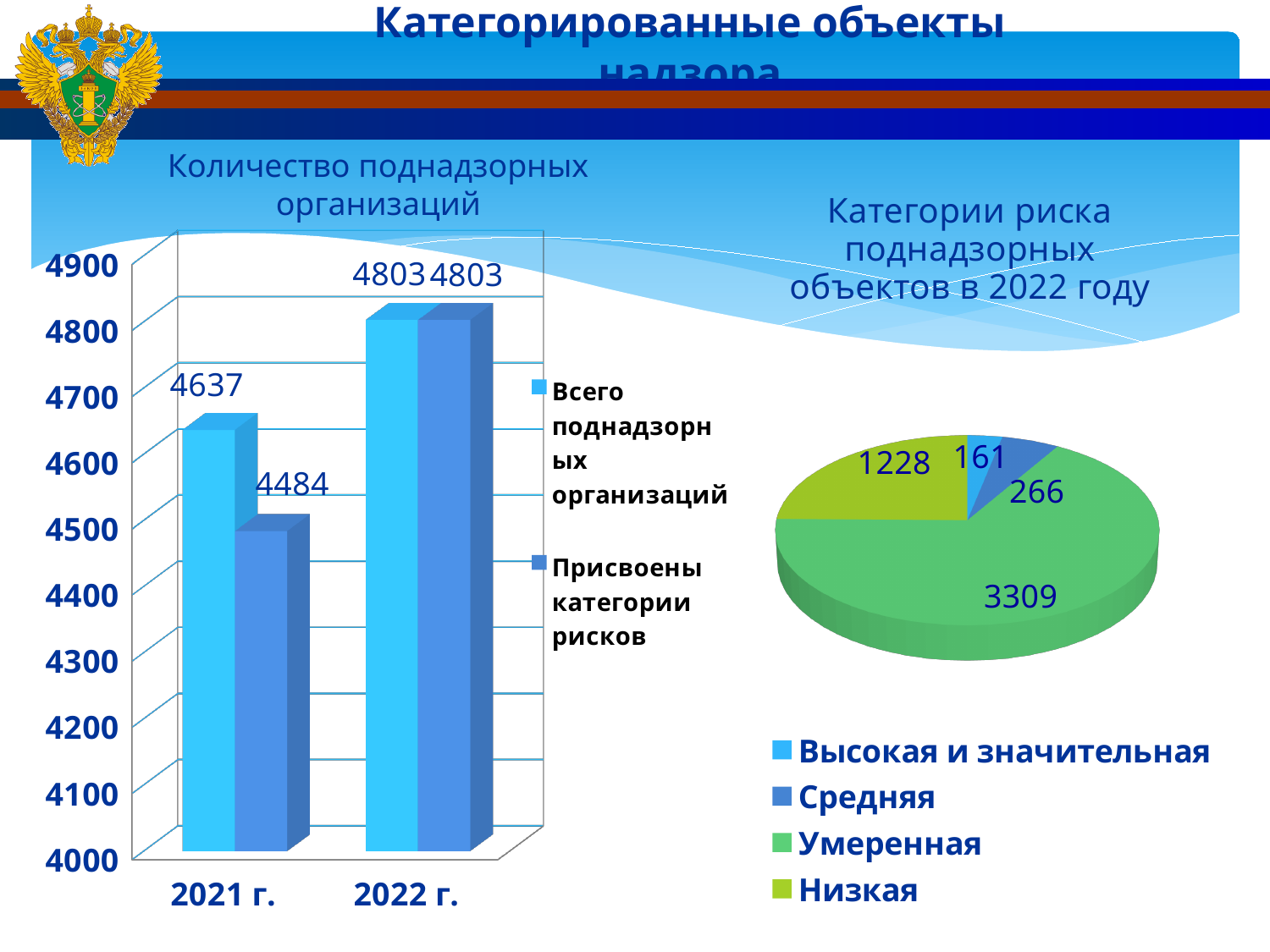
In the chart 'Количество поднадзорных организаций', what is the value of 'Присвоены категории рисков' for 2021 г.? 4484 In the chart 'Количество поднадзорных организаций', what is the difference between 'Всего поднадзорных организаций' and 'Присвоены категории рисков' in 2021 г.? 153 In the pie chart 'Категории риска поднадзорных объектов в 2022 году', what is the value for 'Умеренная'? 3309 In the chart 'Количество поднадзорных организаций', does 'Присвоены категории рисков' rise or fall from 2021 г. to 2022 г.? rise How many series does the legend of the chart 'Количество поднадзорных организаций' list? 2 In the chart 'Количество поднадзорных организаций', what is the value of 'Всего поднадзорных организаций' for 2021 г.? 4637 How many categories does the pie chart 'Категории риска поднадзорных объектов в 2022 году' show? 4 In the pie chart 'Категории риска поднадзорных объектов в 2022 году', which is larger: 'Средняя' or 'Низкая'? Низкая In the pie chart 'Категории риска поднадзорных объектов в 2022 году', which category has the smallest value? Высокая и значительная In the chart 'Количество поднадзорных организаций', by how much did 'Всего поднадзорных организаций' change from 2021 г. to 2022 г.? 166 What kind of chart is 'Количество поднадзорных организаций'? bar chart In the chart 'Количество поднадзорных организаций', what is the value of 'Присвоены категории рисков' for 2022 г.? 4803